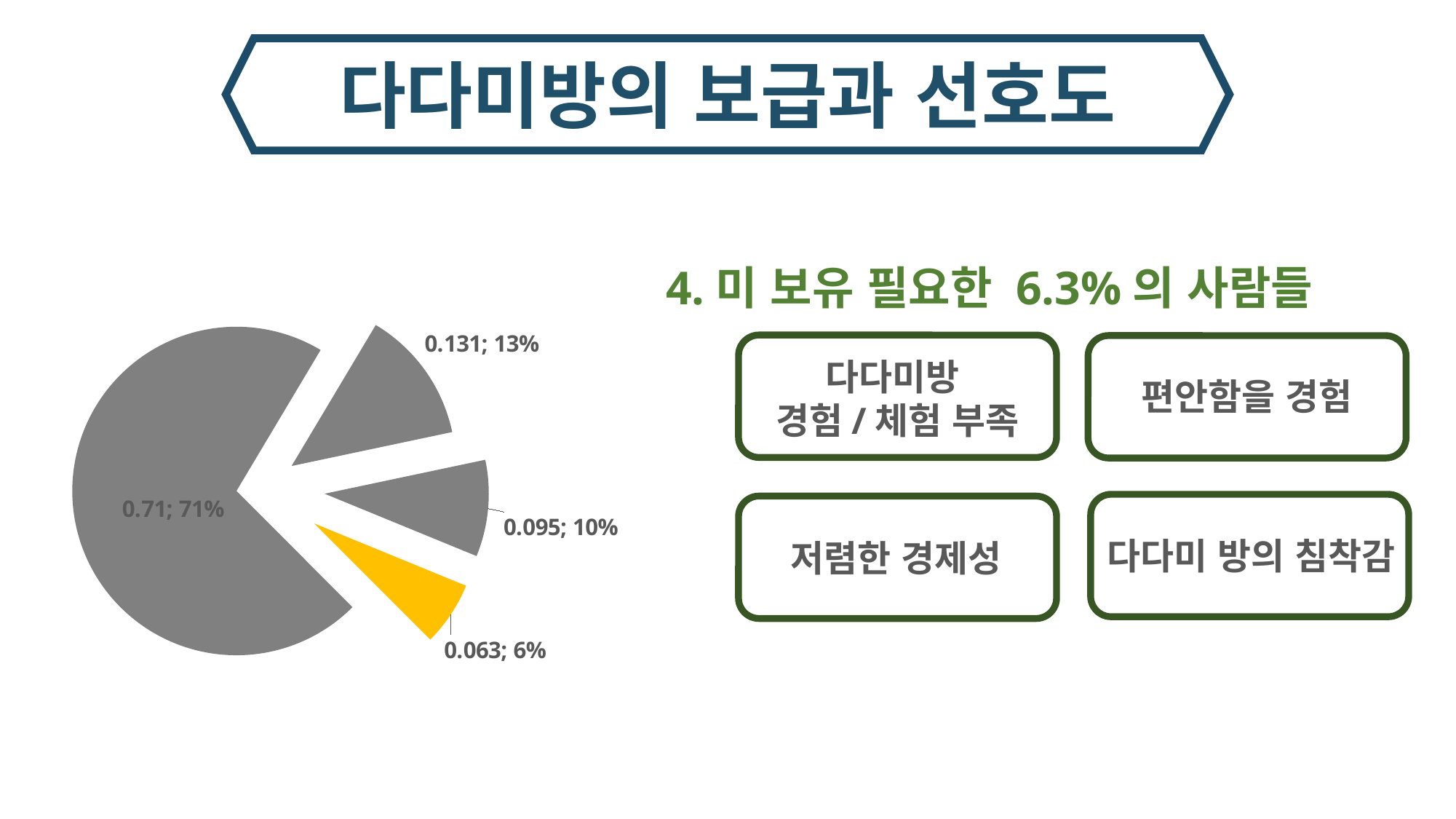
What is the value label of the yellow slice in the pie chart? 0.063; 6% Is the largest slice of the pie chart greater or less than 50%? greater What share of the pie does the largest slice represent? 71% How many slices of the pie chart are grey? 3 What is the value label of the smallest slice in the pie chart? 0.063; 6% What colour is the smallest slice of the pie chart? yellow What kind of chart is shown on the left of the slide? pie chart How many slices does the pie chart have? 4 What is the value label of the largest slice in the pie chart? 0.71; 71% What share of the pie does the yellow slice represent? 6% Is the yellow slice larger or smaller than the slice labelled 0.095; 10%? smaller What is the difference in percentage between the largest slice (71%) and the slice labelled 13%? 58%